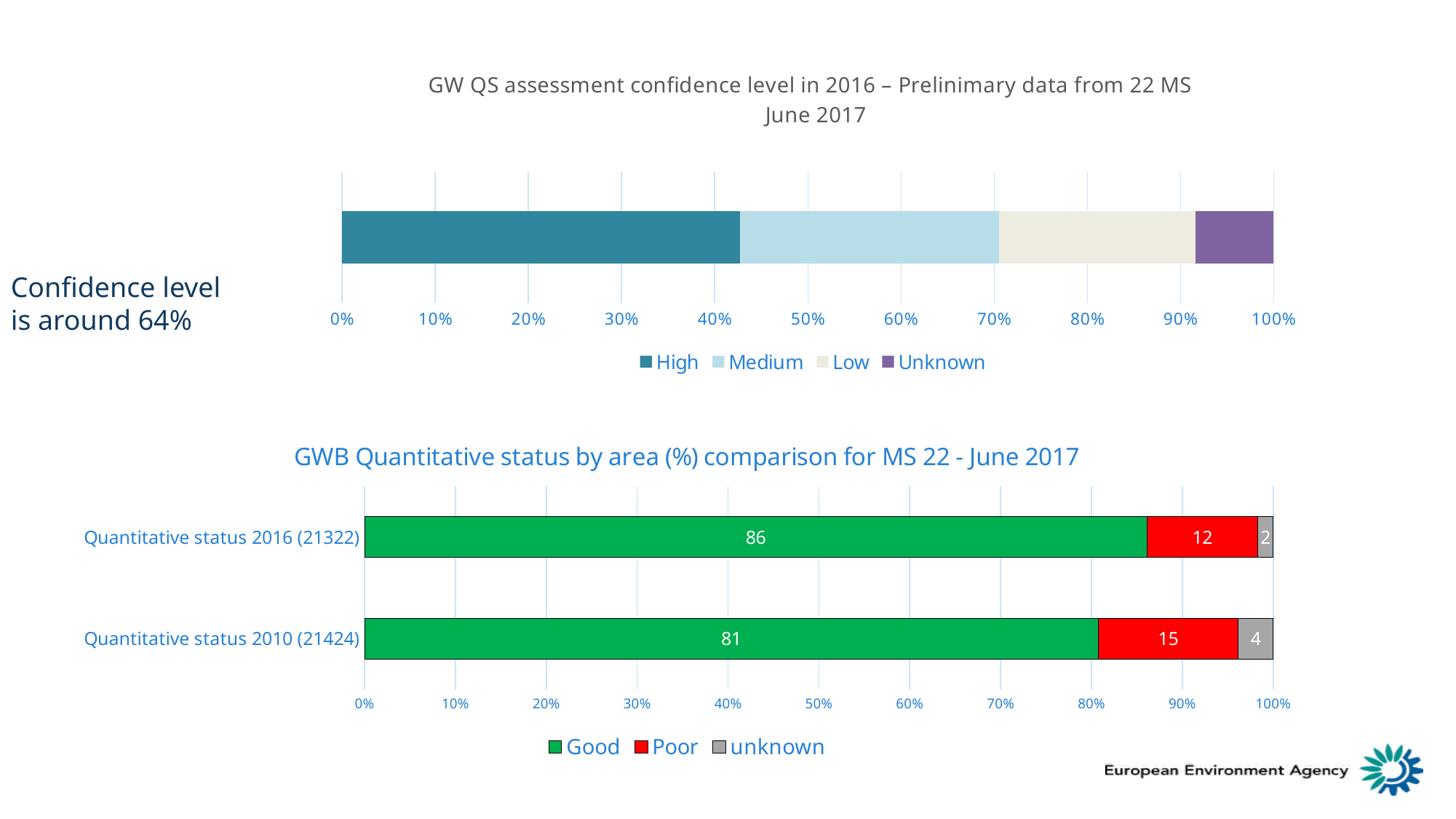
In the bottom chart (GWB Quantitative status by area), how many categories are plotted? 2 In the top chart (GW QS assessment confidence level in 2016), how many series does the legend list? 4 In the bottom chart (GWB Quantitative status by area), what is the Good value for Quantitative status 2016 (21322)? 86 In the top chart (GW QS assessment confidence level in 2016), which confidence level has the largest share of the bar? High In the bottom chart (GWB Quantitative status by area), what is the unknown value for Quantitative status 2016 (21322)? 2 In the bottom chart (GWB Quantitative status by area), what is the difference between the Good values for 2016 and 2010? 5 What kind of chart is the bottom chart (GWB Quantitative status by area)? Stacked bar chart In the top chart (GW QS assessment confidence level in 2016), which confidence level has the smallest share of the bar? Unknown In the bottom chart (GWB Quantitative status by area), what is the Poor value for Quantitative status 2010 (21424)? 15 In the bottom chart (GWB Quantitative status by area), how many series does the legend list? 3 In the top chart (GW QS assessment confidence level in 2016), is the High segment greater or less than 40%? greater In the bottom chart (GWB Quantitative status by area), which has the larger Poor value, Quantitative status 2016 or Quantitative status 2010? Quantitative status 2010 (21424)